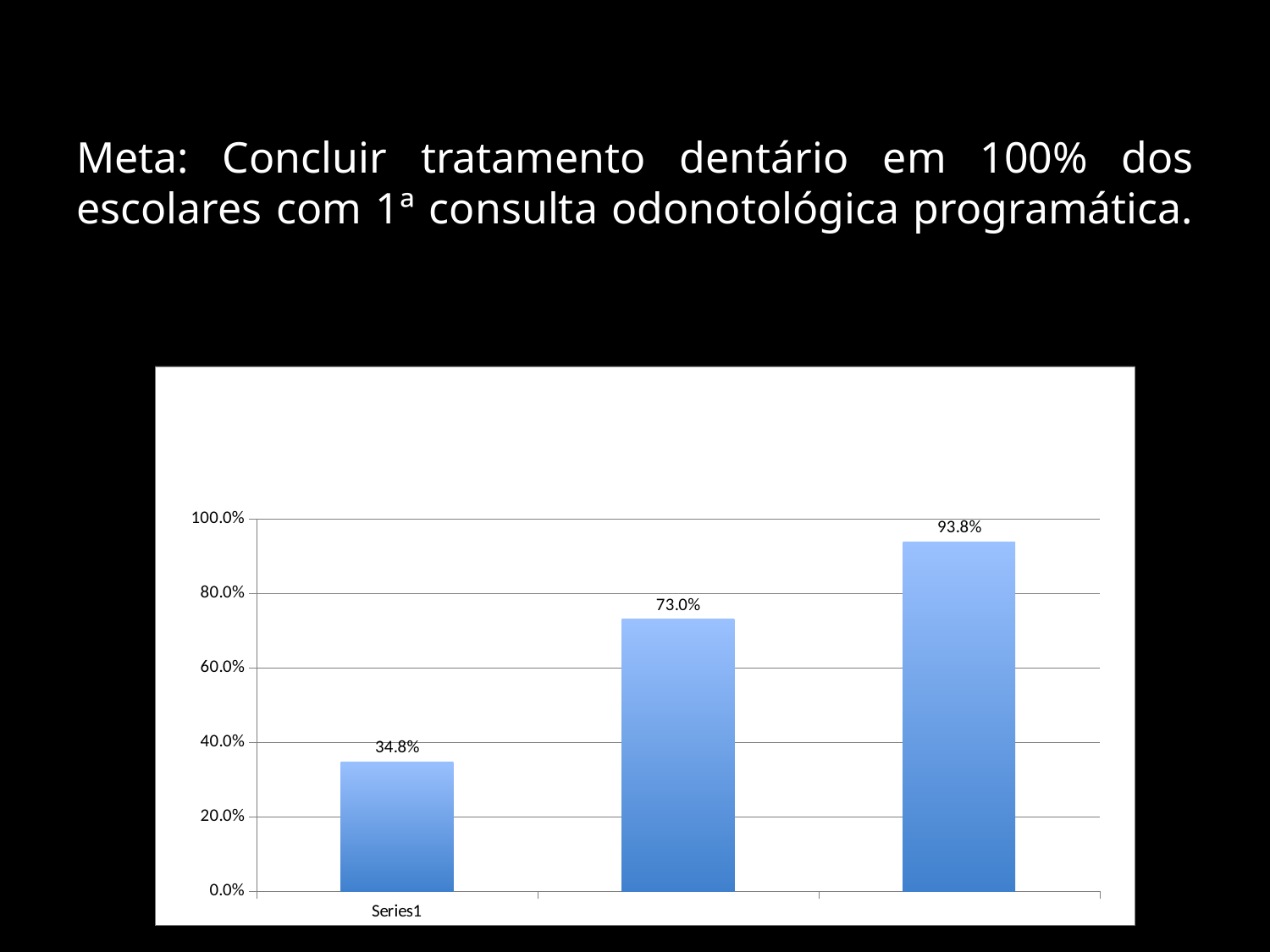
Do the bar values rise or fall from left to right? Rise What kind of chart is shown on the slide? Bar chart What is the value shown on the middle bar? 73.0% What is the difference between the rightmost bar and the leftmost bar? 59.0% How many bars are plotted in the chart? 3 Which bar has the lowest value? The first (leftmost) bar, 34.8% What is the value shown on the first (leftmost) bar? 34.8% Which bar has the highest value? The third (rightmost) bar, 93.8% Is the value of the middle bar greater or less than 80.0%? less What is the value shown on the third (rightmost) bar? 93.8% Which is larger, the middle bar or the leftmost bar? The middle bar What is the difference between the middle bar and the leftmost bar? 38.2%